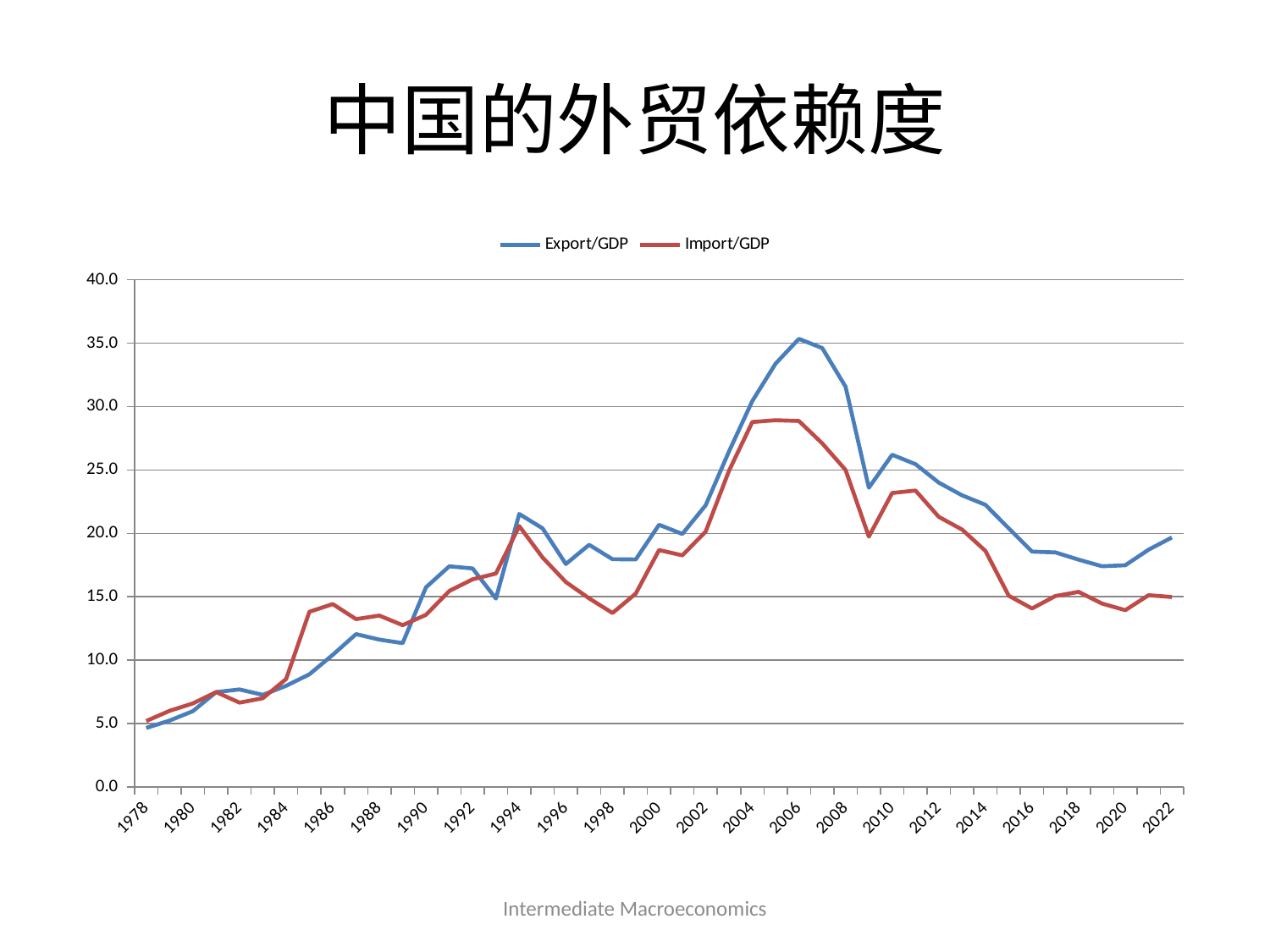
Is the Import/GDP value in 2006 greater or less than 30.0? less Does the Export/GDP series rise or fall between 2006 and 2009? fall In which year does the Export/GDP series reach its highest value? 2006 Is the Export/GDP value in 2006 greater or less than 30.0? greater What is the title of the slide? 中国的外贸依赖度 In which year is the Export/GDP series at its lowest value? 1978 In 2006, which series has the larger value, Export/GDP or Import/GDP? Export/GDP How many series does the legend list? 2 What kind of chart is shown on the slide? line chart Is the Export/GDP value in 2009 greater or less than 25.0? less What are the two series named in the legend? Export/GDP and Import/GDP